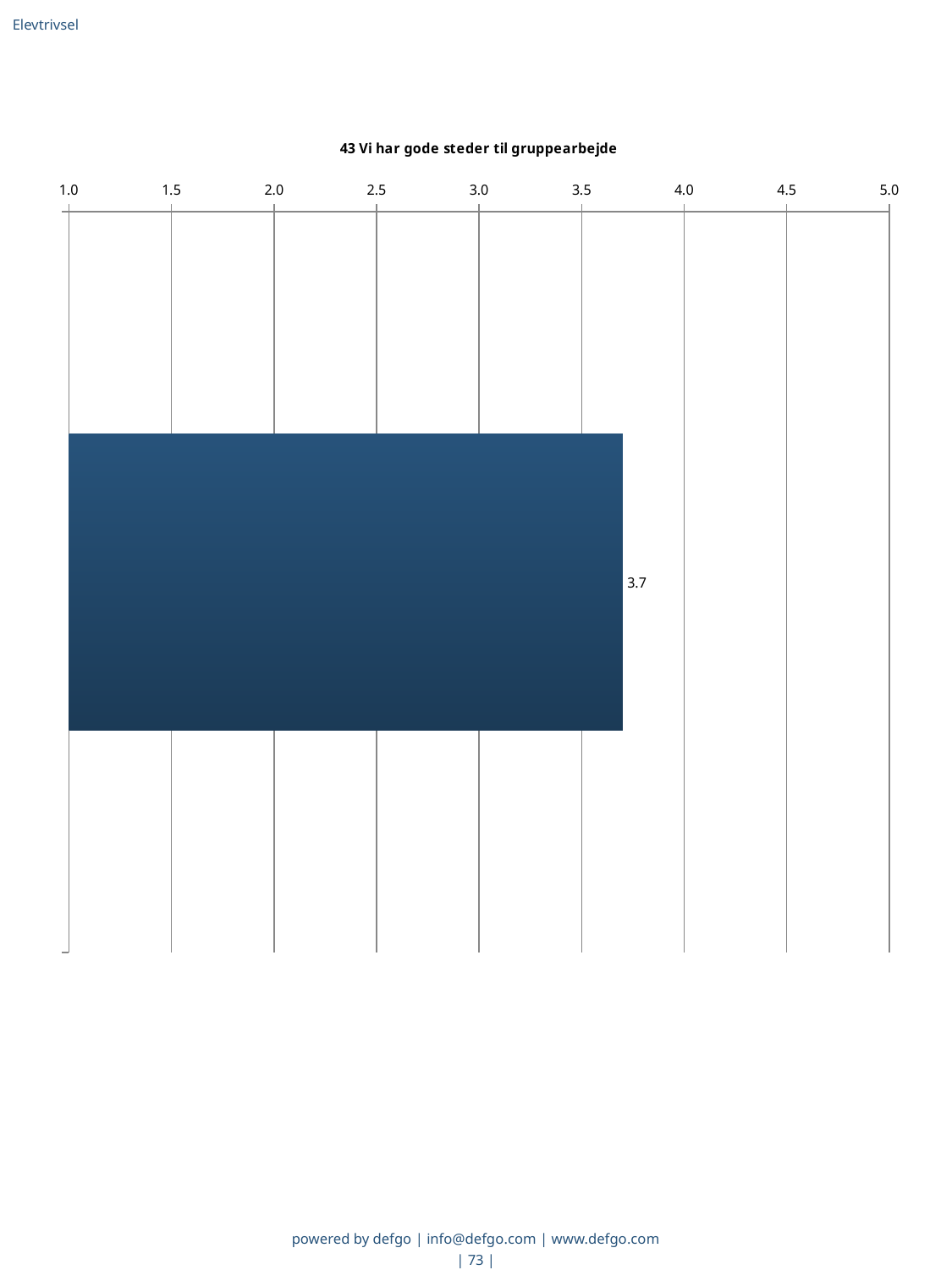
What is the title of the chart? 43 Vi har gode steder til gruppearbejde Are the bars in the chart horizontal or vertical? horizontal What is the highest value shown on the chart's axis? 5.0 Is the value of the bar greater or less than 4.0? less What kind of chart is shown on the slide? bar chart What is the value shown by the bar in the chart? 3.7 Is the value of the bar greater or less than 3.5? greater How many bars are plotted in the chart? 1